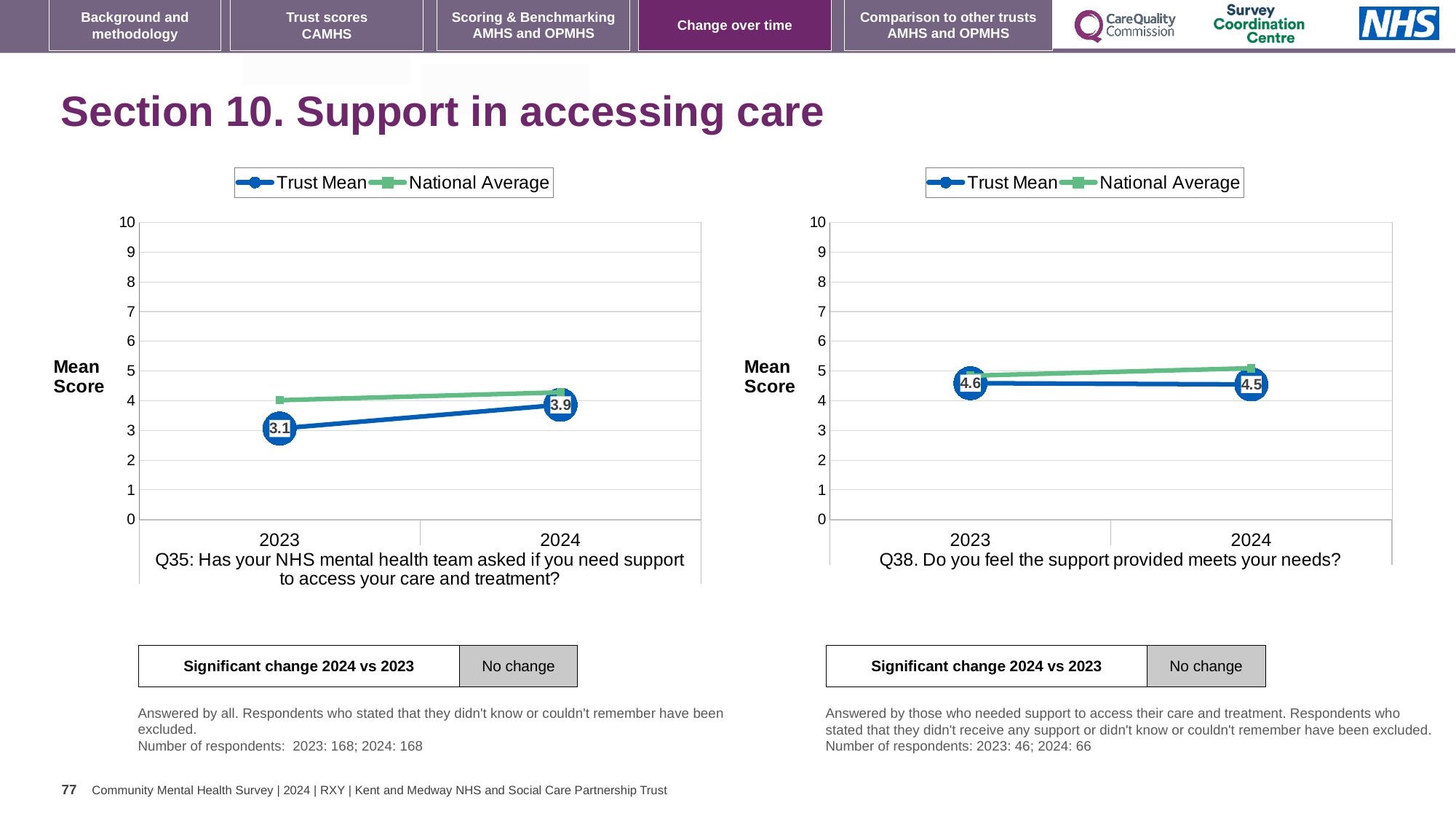
In the Q38 chart on the right, what is the Trust Mean score for 2023? 4.6 In the Q35 chart on the left, does the Trust Mean rise or fall from 2023 to 2024? rise How many years are shown on the x axis of the Q35 chart on the left? 2 How many series does the legend of the Q38 chart on the right list? 2 What kind of chart is the Q35 chart on the left? line chart In the Q35 chart on the left, by how much did the Trust Mean change from 2023 to 2024? 0.8 In the Q38 chart on the right, what is the Trust Mean score for 2024? 4.5 In the Q38 chart on the right, which series is higher in 2024, Trust Mean or National Average? National Average In the Q38 chart on the right, does the Trust Mean rise or fall from 2023 to 2024? fall In the Q35 chart on the left, what is the Trust Mean score for 2024? 3.9 In the Q35 chart on the left, is the National Average for 2023 greater or less than 3? greater In the Q35 chart on the left, what is the Trust Mean score for 2023? 3.1